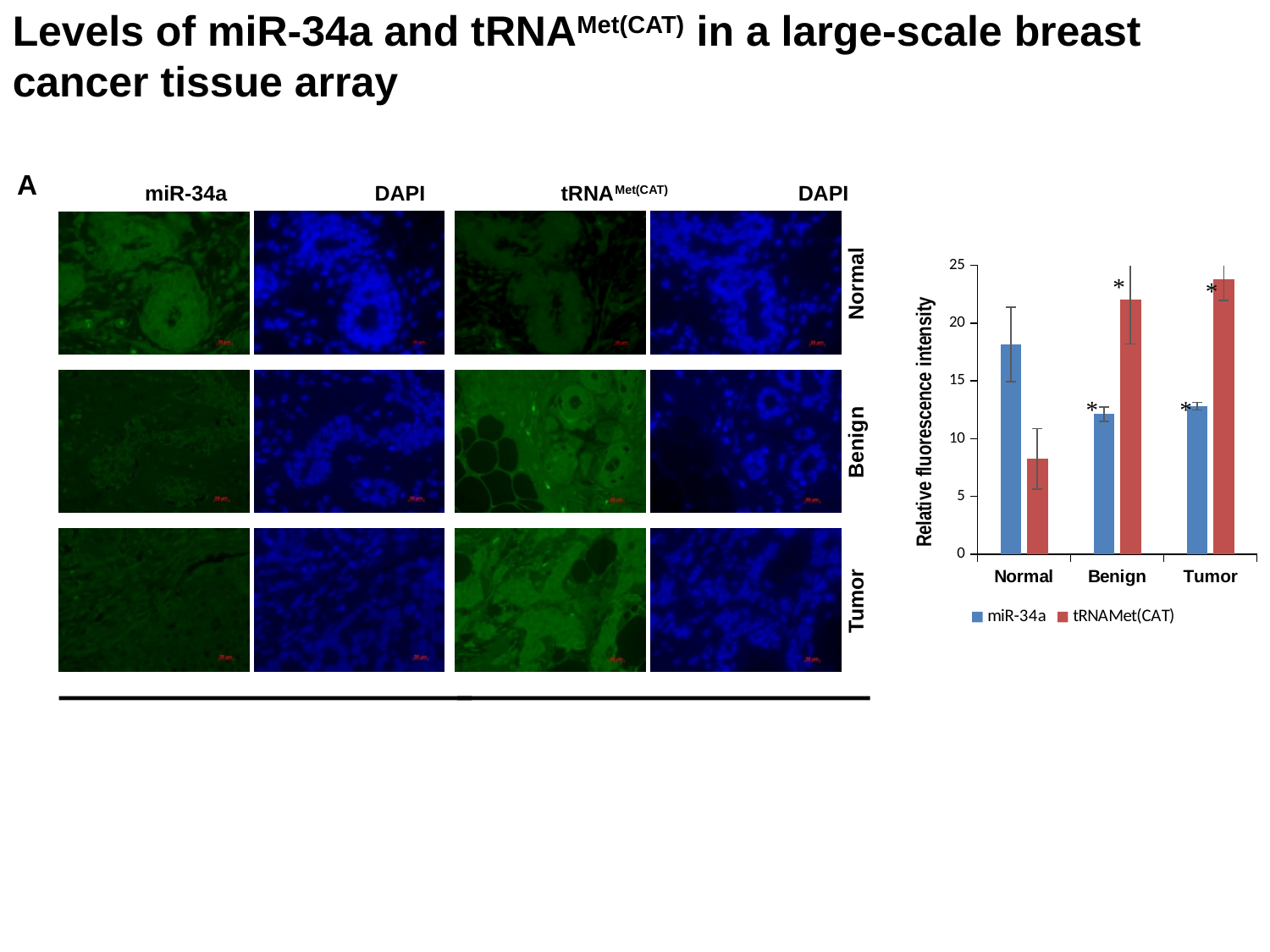
Is the tRNAMet(CAT) value for Benign greater or less than 20? greater How many series does the legend of the bar chart list? 2 In the bar chart, which is larger for the Normal category: miR-34a or tRNAMet(CAT)? miR-34a In the bar chart, which is larger for the Tumor category: miR-34a or tRNAMet(CAT)? tRNAMet(CAT) How many categories are shown on the x axis of the bar chart? 3 Which category has the lowest tRNAMet(CAT) value in the bar chart? Normal What kind of chart is shown on the right of the slide? bar chart What is the y-axis title of the bar chart? Relative fluorescence intensity Is the miR-34a value for Normal greater or less than 15? greater Which category has the highest miR-34a value in the bar chart? Normal Does the tRNAMet(CAT) series rise or fall from Normal to Tumor along the x axis? rise Is the tRNAMet(CAT) value for Normal greater or less than 10? less